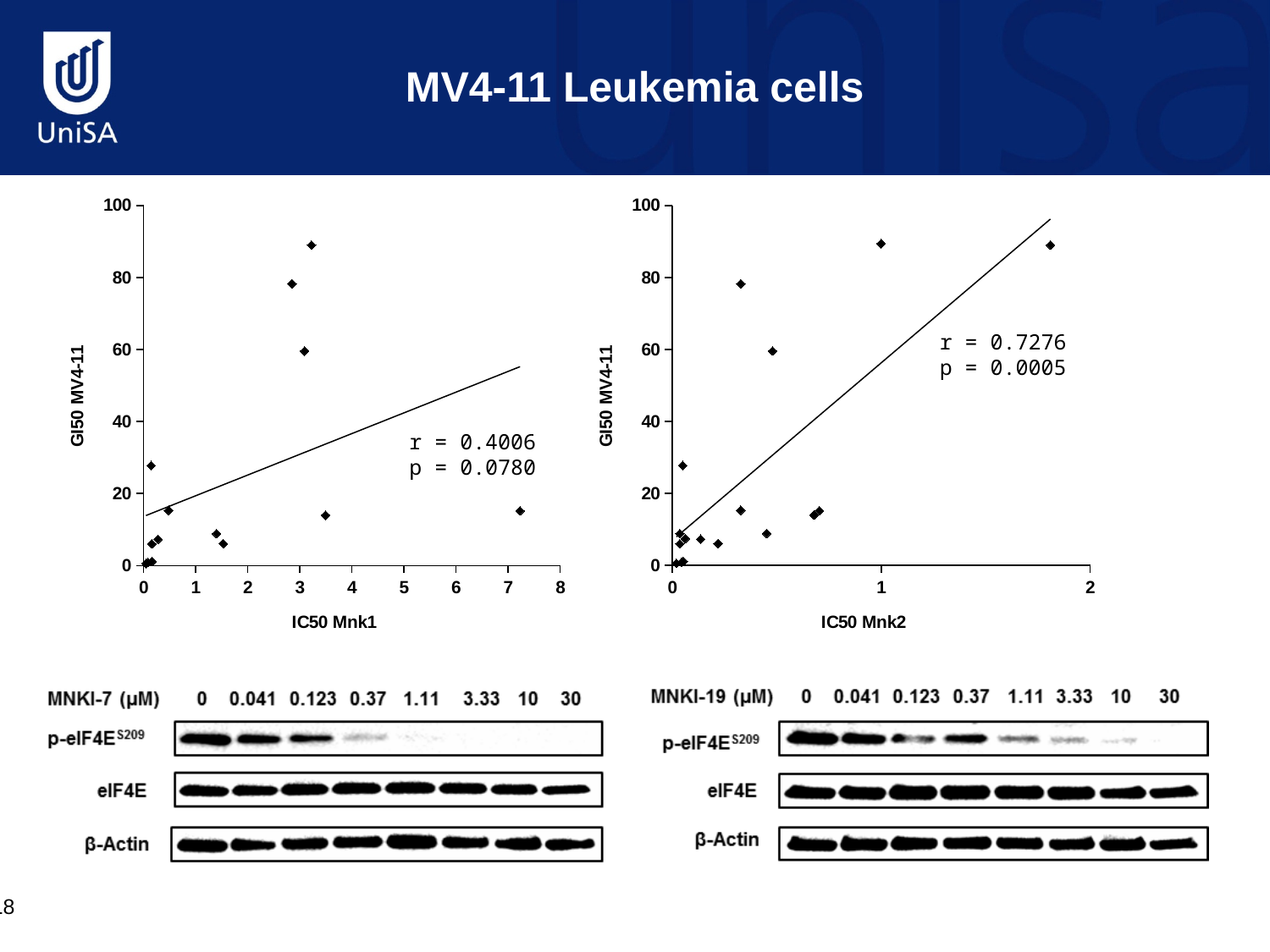
What is the y-axis label of the right chart (IC50 Mnk2)? GI50 MV4-11 In the right chart (IC50 Mnk2), what is the correlation coefficient r printed on the chart? r = 0.7276 What kind of chart is the right chart (IC50 Mnk2)? scatter plot In the left chart (IC50 Mnk1), what is the p value printed on the chart? p = 0.0780 In the left chart (IC50 Mnk1), what is the correlation coefficient r printed on the chart? r = 0.4006 In the right chart (IC50 Mnk2), what is the p value printed on the chart? p = 0.0005 In the left chart (IC50 Mnk1), is the GI50 value of the highest point greater or less than 80? greater In the left chart (IC50 Mnk1), does the fitted line rise or fall as IC50 Mnk1 increases? rise In the right chart (IC50 Mnk2), does the fitted line rise or fall as IC50 Mnk2 increases? rise What kind of chart is the left chart (IC50 Mnk1)? scatter plot In the left chart (IC50 Mnk1), is the GI50 value of the point with the largest IC50 Mnk1 (around 7) greater or less than 20? less Which chart shows the larger correlation coefficient r, the left chart (IC50 Mnk1) or the right chart (IC50 Mnk2)? the right chart (IC50 Mnk2)